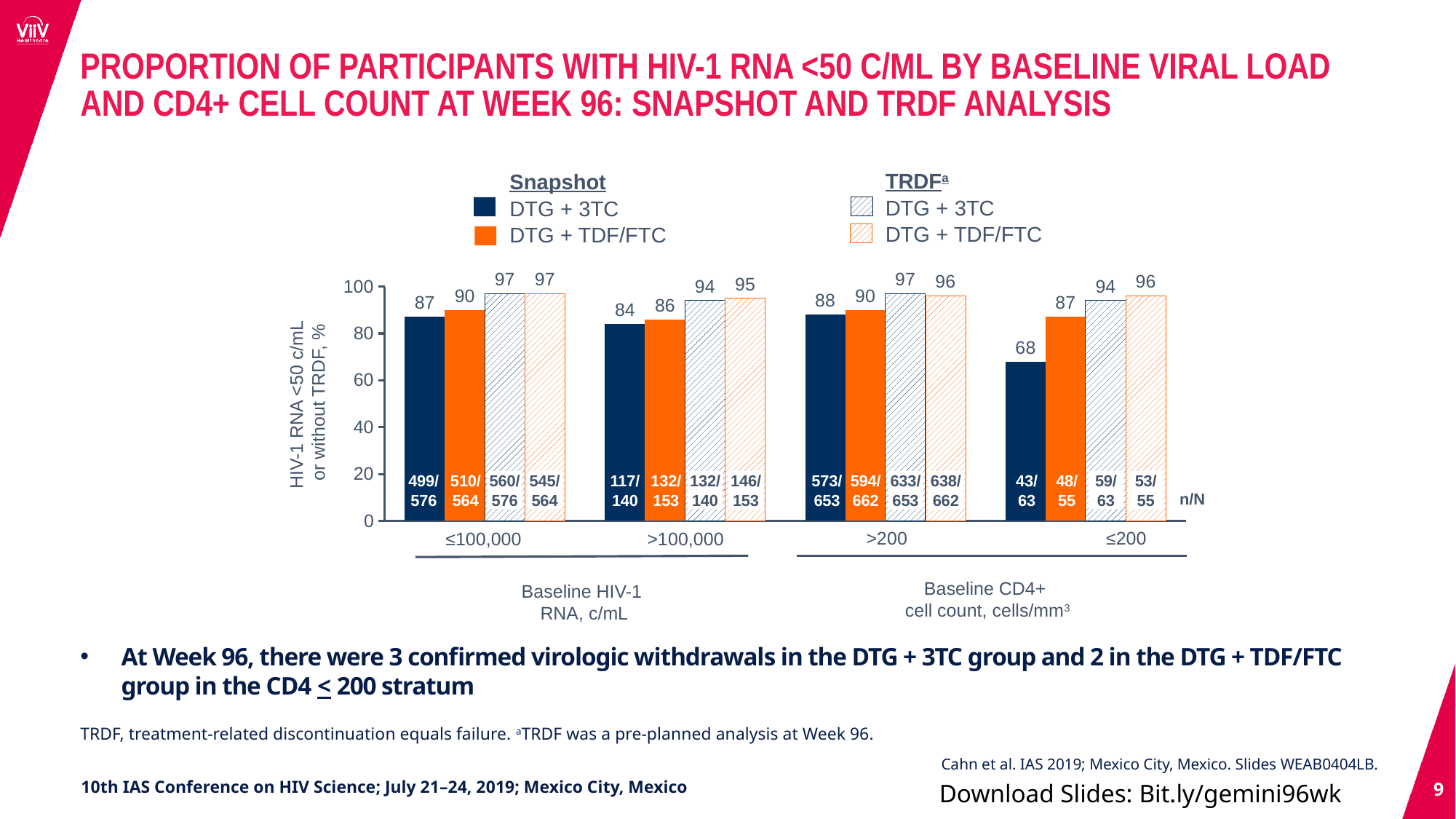
What is the TRDF DTG + 3TC value for the baseline HIV-1 RNA >100,000 c/mL group? 94 What is the n/N shown for Snapshot DTG + 3TC in the baseline CD4+ cell count ≤200 group? 43/63 Is the Snapshot DTG + 3TC value for the baseline CD4+ cell count ≤200 group greater or less than 80? less In the baseline HIV-1 RNA >100,000 c/mL group, which is larger: the Snapshot DTG + 3TC value or the Snapshot DTG + TDF/FTC value? Snapshot DTG + TDF/FTC (86) How many series does the legend list in total? 4 What is the Snapshot DTG + TDF/FTC value for the baseline CD4+ cell count ≤200 cells/mm³ group? 87 What is the y-axis label of the chart? HIV-1 RNA <50 c/mL or without TRDF, % What is the Snapshot DTG + 3TC value for the baseline HIV-1 RNA ≤100,000 c/mL group? 87 Which bar has the lowest value on the chart? Snapshot DTG + 3TC in the CD4+ ≤200 group (68) What type of chart is shown on the slide? Bar chart How many baseline subgroup categories are shown on the x axis of the chart? 4 What is the difference between the Snapshot DTG + TDF/FTC and Snapshot DTG + 3TC values in the baseline CD4+ cell count ≤200 group? 19